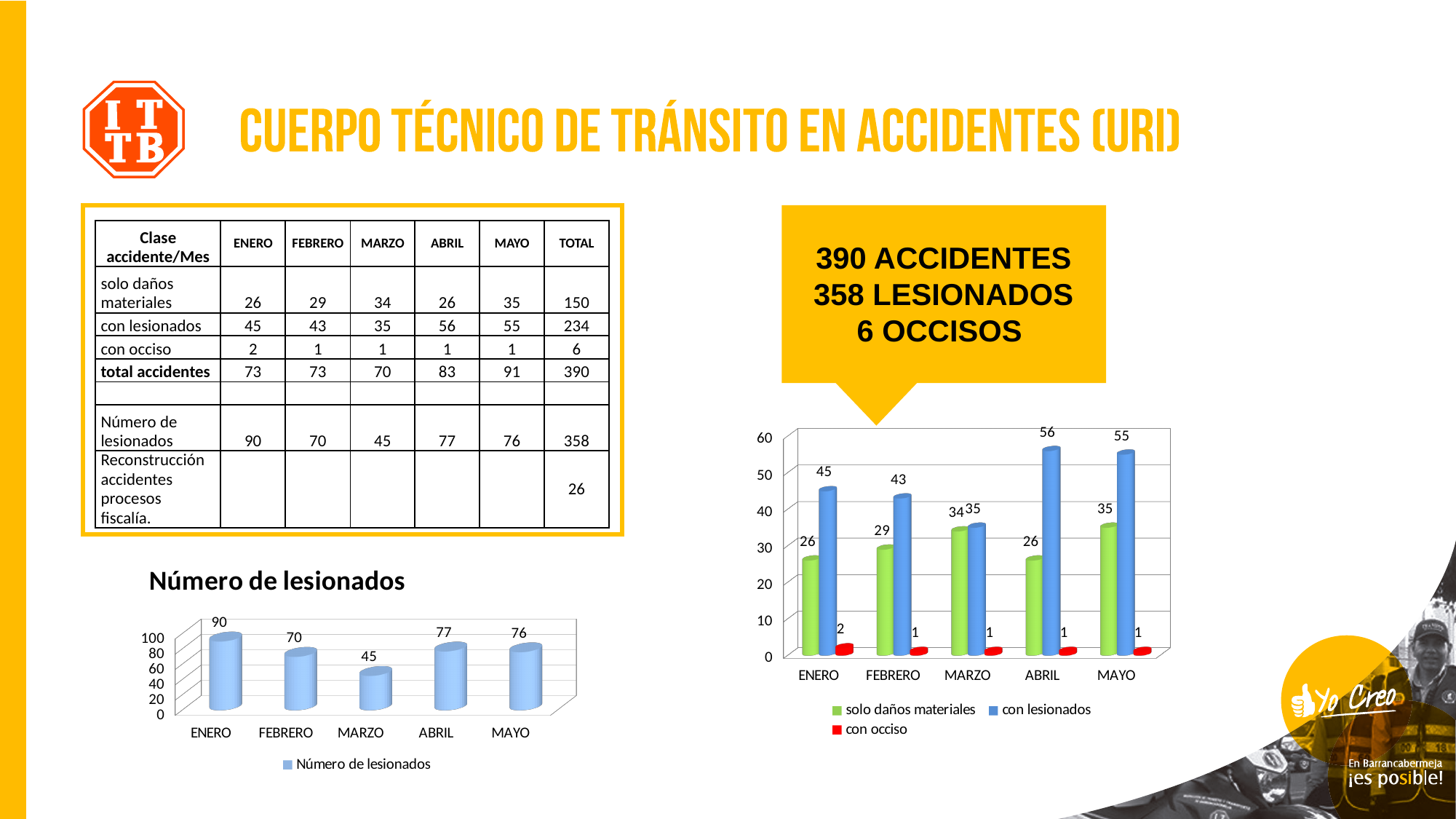
In the chart on the right, what is the value for 'con lesionados' in ABRIL? 56 In the 'Número de lesionados' chart, what kind of chart is it? bar chart In the 'Número de lesionados' chart, what is the value for MARZO? 45 In the chart on the right, which is larger in FEBRERO: 'solo daños materiales' or 'con lesionados'? con lesionados In the 'Número de lesionados' chart, which month has the highest value? ENERO In the 'Número de lesionados' chart, what is the difference between the values for ENERO and FEBRERO? 20 In the 'Número de lesionados' chart, which month has the lowest value? MARZO In the chart on the right, which month has the highest value for 'con lesionados'? ABRIL In the chart on the right, how many series does the legend list? 3 In the chart on the right, what is the value for 'solo daños materiales' in MAYO? 35 In the 'Número de lesionados' chart, how many months are shown on the x axis? 5 In the chart on the right, what is the difference between 'con lesionados' and 'solo daños materiales' in ABRIL? 30